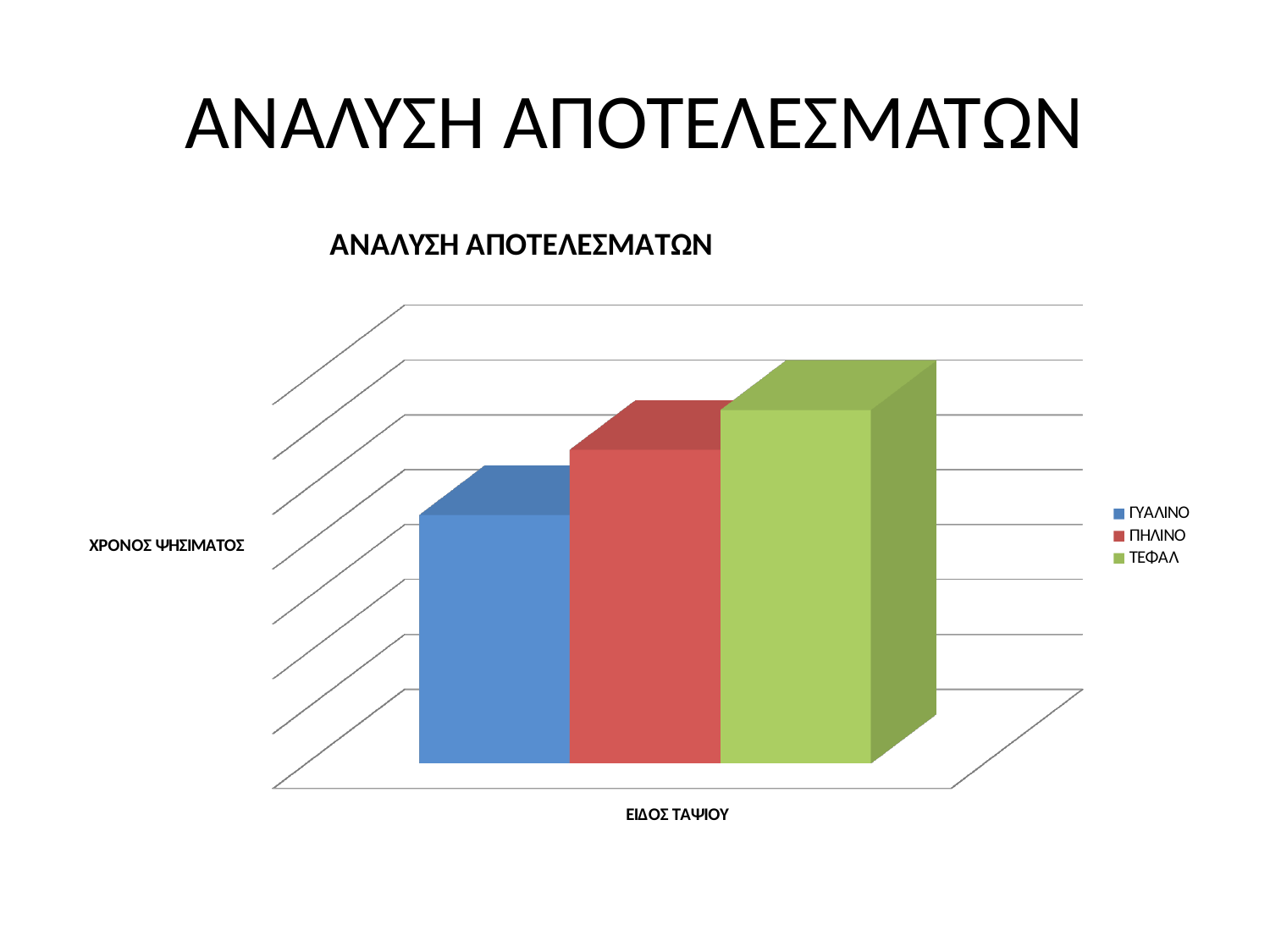
What colour is the bar for ΠΗΛΙΝΟ? red Which series has the shortest bar? ΓΥΑΛΙΝΟ What kind of chart is shown on the slide? bar chart How many series does the legend list? 3 How many bars are plotted in the chart? 3 Which series has the tallest bar? ΤΕΦΑΛ Which bar is taller, ΤΕΦΑΛ or ΠΗΛΙΝΟ? ΤΕΦΑΛ What is the title of the chart? ΑΝΑΛΥΣΗ ΑΠΟΤΕΛΕΣΜΑΤΩΝ Do the bars rise or fall from left to right? rise Which bar is taller, ΠΗΛΙΝΟ or ΓΥΑΛΙΝΟ? ΠΗΛΙΝΟ